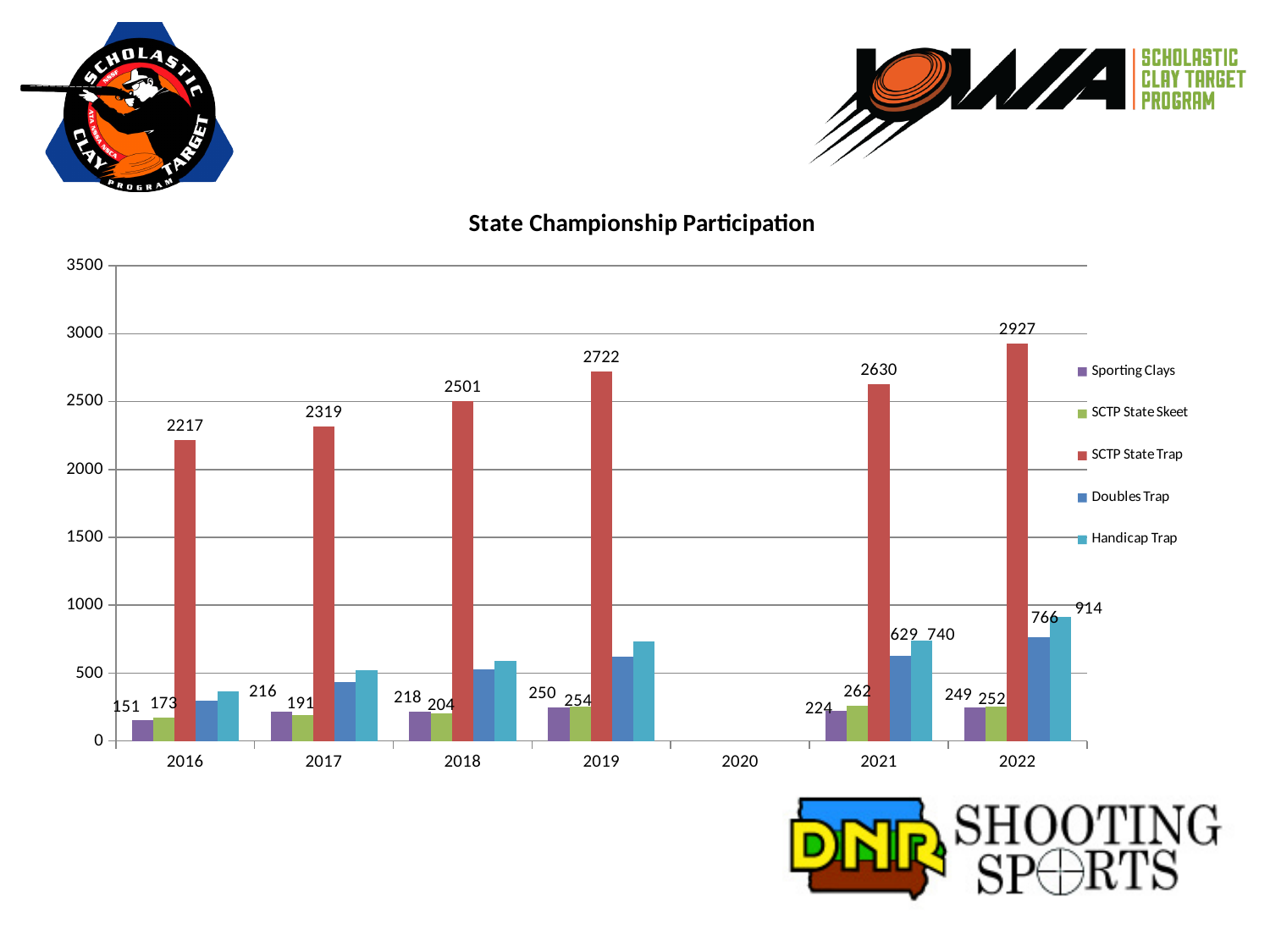
What is the difference between SCTP State Trap participation in 2022 and 2021? 297 In which year is SCTP State Trap participation highest? 2022 What kind of chart is shown on the slide? bar chart What is the value for Doubles Trap in 2021? 629 How many series does the legend list? 5 What is the value for Sporting Clays in 2016? 151 What is the value for SCTP State Trap in 2022? 2927 In 2022, which is larger: Handicap Trap or Doubles Trap? Handicap Trap Does SCTP State Trap participation rise or fall from 2016 to 2019? rise How many years are shown on the x axis? 7 Is the value for Doubles Trap in 2016 greater or less than 500? less In which year is SCTP State Trap participation lowest? 2016